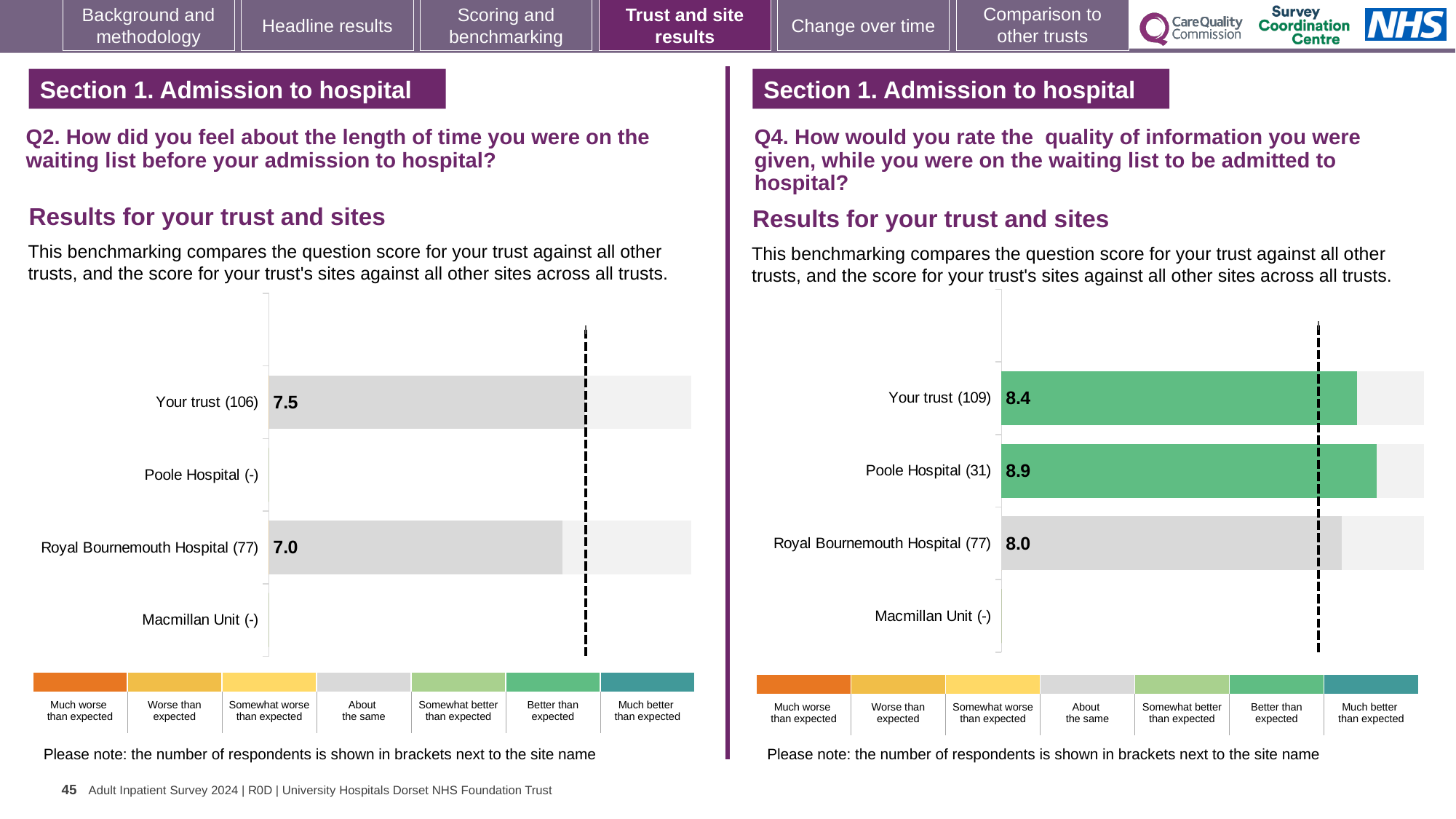
In the Q4 chart on the right, which has the larger score, Your trust or Poole Hospital? Poole Hospital In the Q4 chart on the right, what is the difference between the scores for Poole Hospital and Royal Bournemouth Hospital? 0.9 What kind of chart is used in the Q4 chart on the right? Bar chart In the Q4 chart on the right, which site or trust has the highest score? Poole Hospital In the Q2 chart on the left, what is the difference between the scores for Your trust and Royal Bournemouth Hospital? 0.5 In the Q2 chart on the left, what is the score for Royal Bournemouth Hospital? 7.0 In the Q4 chart on the right, what is the score for Poole Hospital? 8.9 In the Q4 chart on the right, which of the labelled bars has the lowest score? Royal Bournemouth Hospital How many categories (trust and sites) are listed on the y axis of the Q2 chart on the left? 4 In the Q4 chart on the right, what is the score for Royal Bournemouth Hospital? 8.0 In the Q2 chart on the left, what is the score for Your trust? 7.5 In the Q4 chart on the right, what is the score for Your trust? 8.4